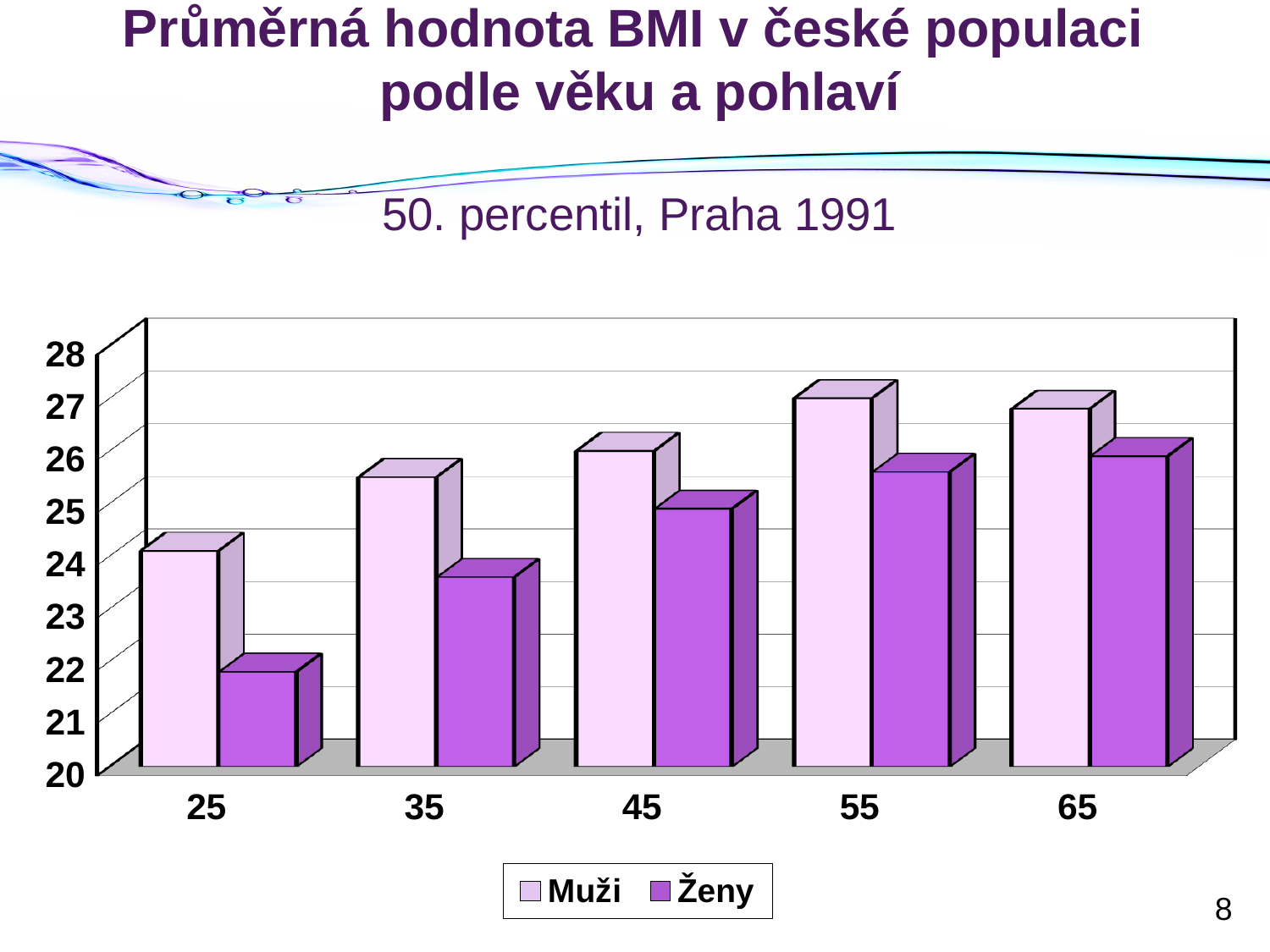
Which age category has the lowest value for Ženy? 25 How many age categories are shown on the x axis? 5 Do the values for Ženy rise or fall as age increases from 25 to 65? rise Is the value for Ženy at age 35 greater or less than 24? less How many series does the legend list? 2 What are the two series named in the legend? Muži and Ženy Is the value for Ženy at age 25 greater or less than 23? less At age 25, which series has the larger value, Muži or Ženy? Muži Is the value for Muži at age 55 greater or less than 26? greater What kind of chart is shown on the slide? bar chart Which age category has the lowest value for Muži? 25